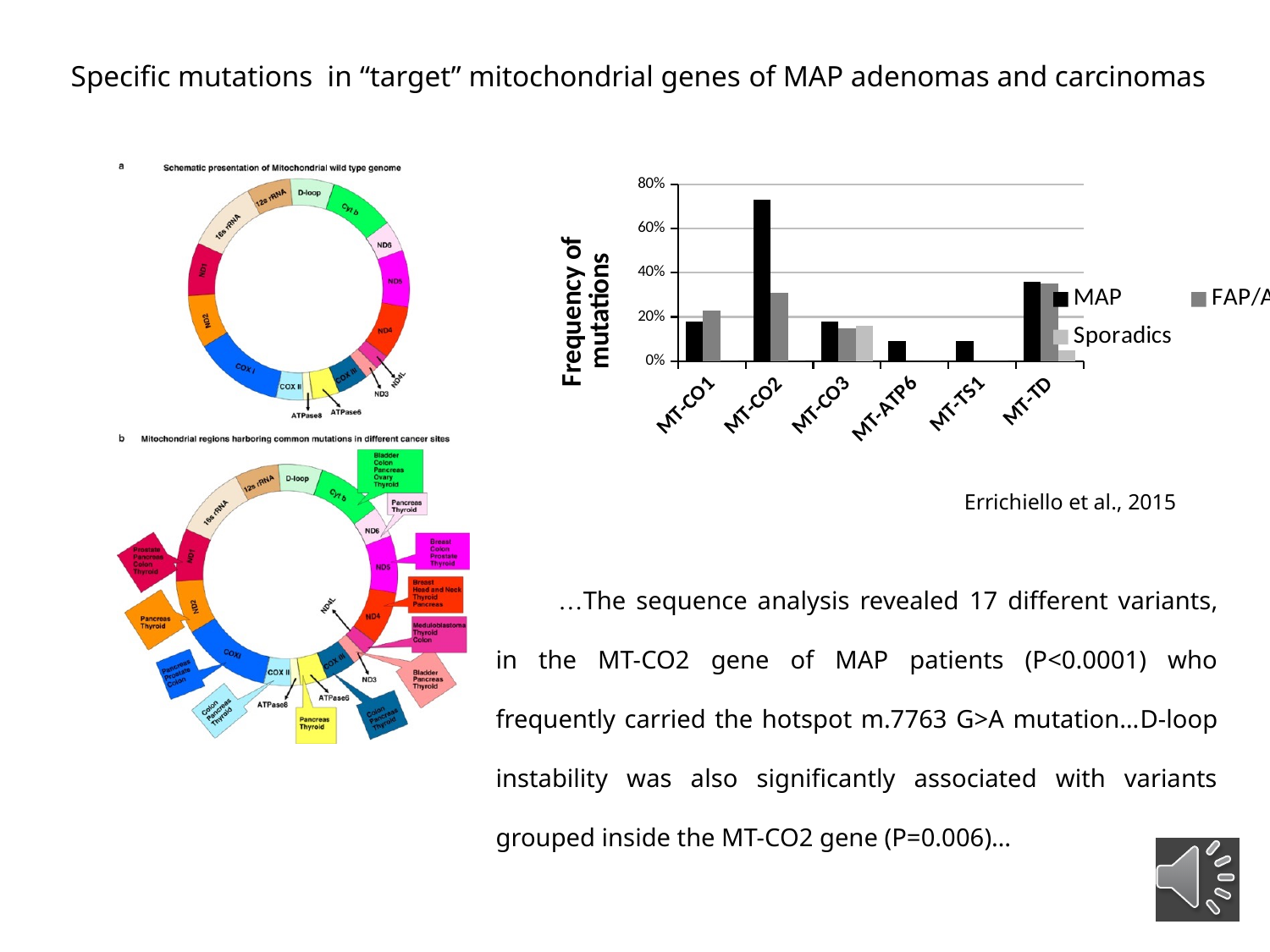
In the bar chart, is the MAP value for MT-TD greater or less than 20%? greater What is the label of the y axis of the bar chart? Frequency of mutations How many series does the legend of the bar chart list? 3 In the bar chart, is the MAP value for MT-ATP6 greater or less than 20%? less In the bar chart, which is larger for MT-CO2: the MAP value or the FAP value? MAP In the bar chart, is the MAP value for MT-CO2 greater or less than 60%? greater In the bar chart, which is larger for MT-CO3: the MAP value or the Sporadics value? MAP In the bar chart, which gene has the highest frequency of mutations for the MAP series? MT-CO2 What colour are the bars for the MAP series in the bar chart? black How many gene categories are shown on the x axis of the bar chart? 6 What kind of chart is shown on the right side of the slide? bar chart